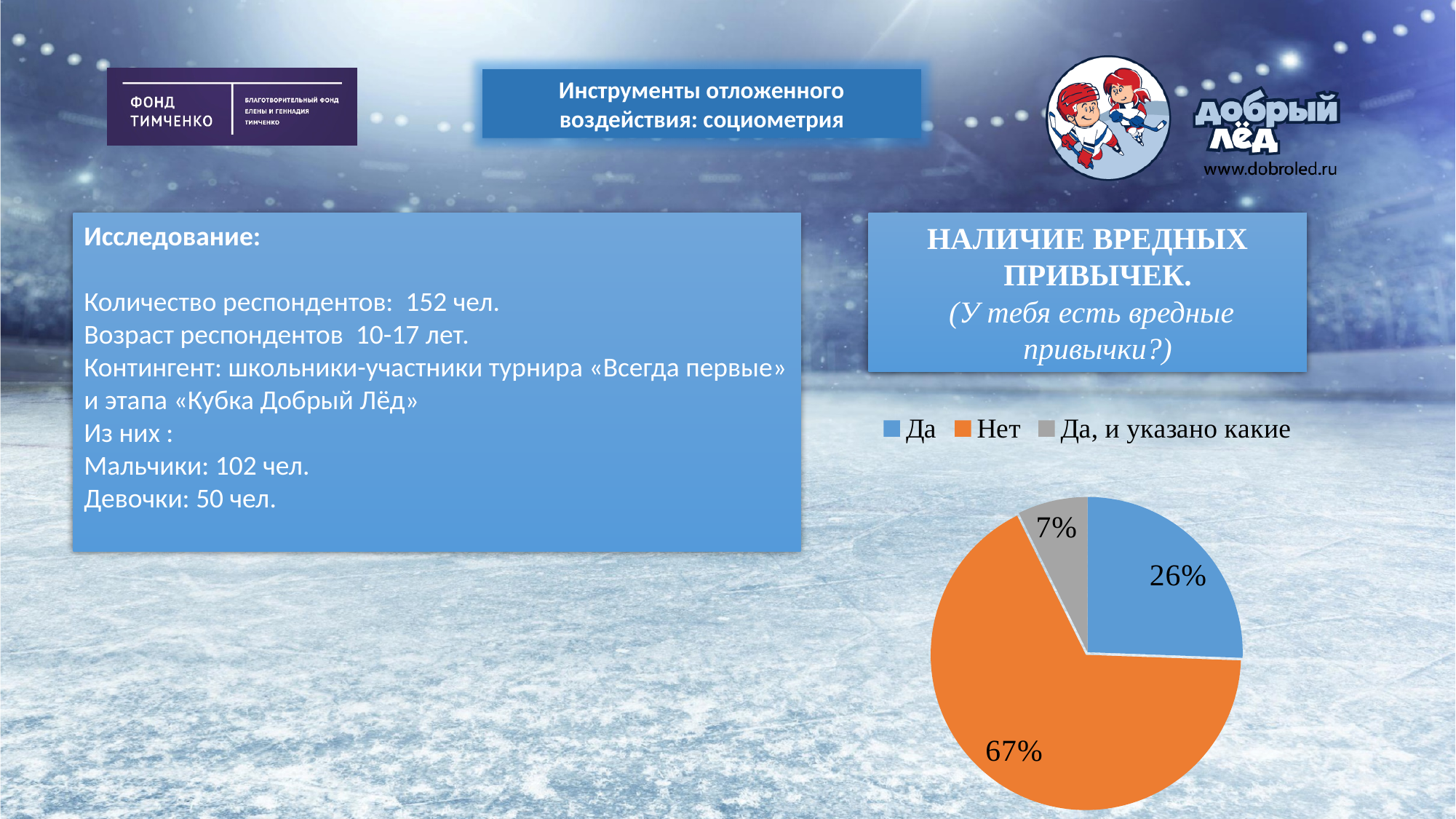
What share of the pie chart is the "Да" slice? 26% What kind of chart is shown on the slide? Pie chart Which slice is larger, "Да" or "Да, и указано какие"? Да What share of the pie chart is the "Да, и указано какие" slice? 7% Which category has the smallest slice in the pie chart? Да, и указано какие How many entries does the legend of the pie chart list? 3 What share of the pie chart is the "Нет" slice? 67% How many slices does the pie chart have? 3 What is the difference in percentage points between the "Нет" slice and the "Да" slice? 41% Which category has the largest slice in the pie chart? Нет What is the combined share of the two "Да" slices ("Да" and "Да, и указано какие")? 33% What colour is the "Нет" slice in the pie chart? Orange